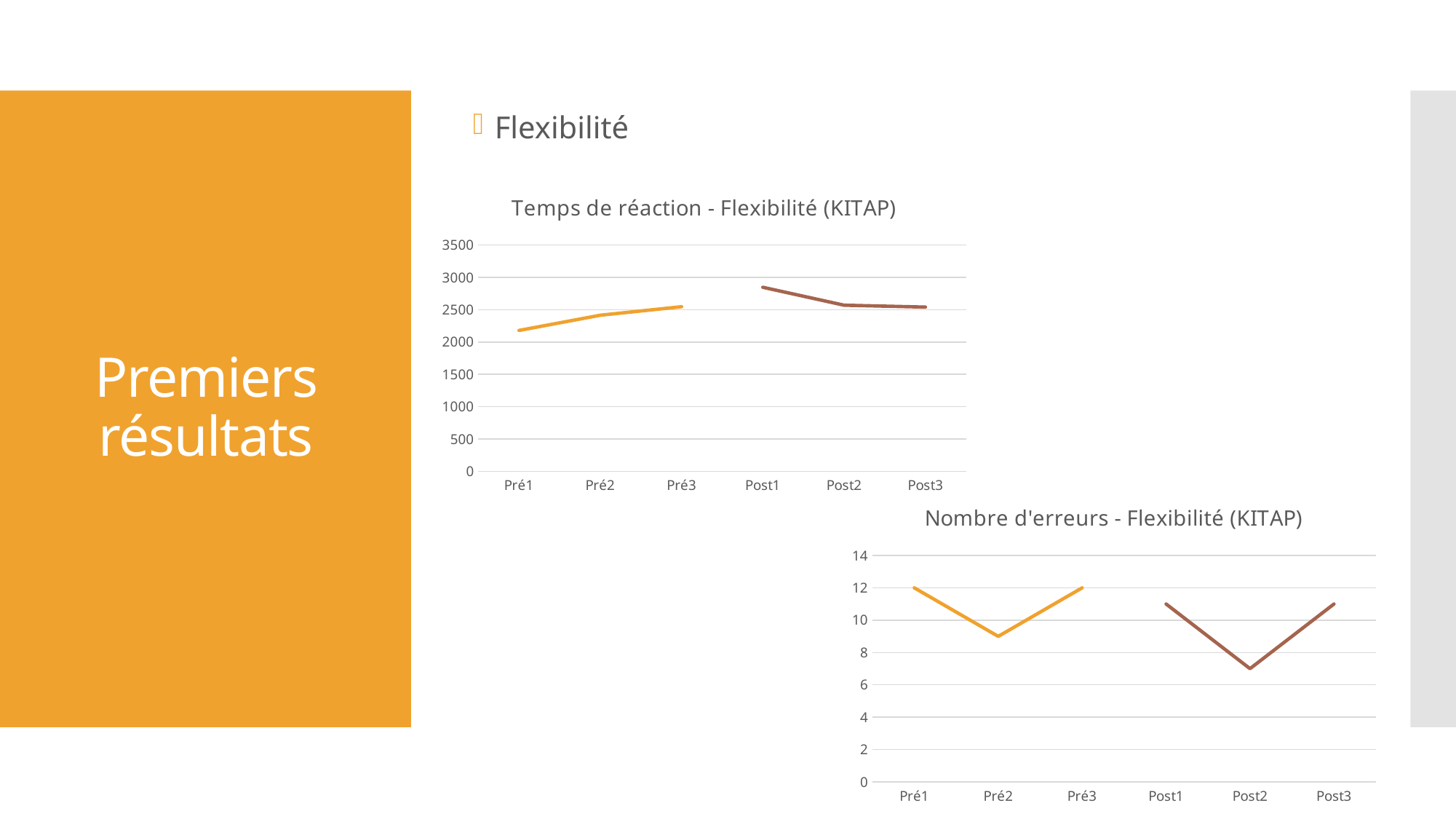
In the 'Nombre d'erreurs - Flexibilité (KITAP)' chart, is the value for Post2 greater or less than 8? less In the 'Nombre d'erreurs - Flexibilité (KITAP)' chart, which category has the lowest value? Post2 In the 'Temps de réaction - Flexibilité (KITAP)' chart, do the values rise or fall from Pré1 to Pré3? rise In the 'Temps de réaction - Flexibilité (KITAP)' chart, is the value for Pré1 greater or less than 2500? less In the 'Nombre d'erreurs - Flexibilité (KITAP)' chart, what is the value for Pré1? 12 In the 'Temps de réaction - Flexibilité (KITAP)' chart, is the value for Post1 greater or less than 2500? greater In the 'Temps de réaction - Flexibilité (KITAP)' chart, which category has the highest value? Post1 In the 'Nombre d'erreurs - Flexibilité (KITAP)' chart, what is the value for Pré3? 12 In the 'Temps de réaction - Flexibilité (KITAP)' chart, which category has the lowest value? Pré1 In the 'Temps de réaction - Flexibilité (KITAP)' chart, how many categories are shown on the x axis? 6 In the 'Nombre d'erreurs - Flexibilité (KITAP)' chart, which is larger, the value for Pré2 or the value for Post1? Post1 What kind of chart is the 'Temps de réaction - Flexibilité (KITAP)' chart? line chart